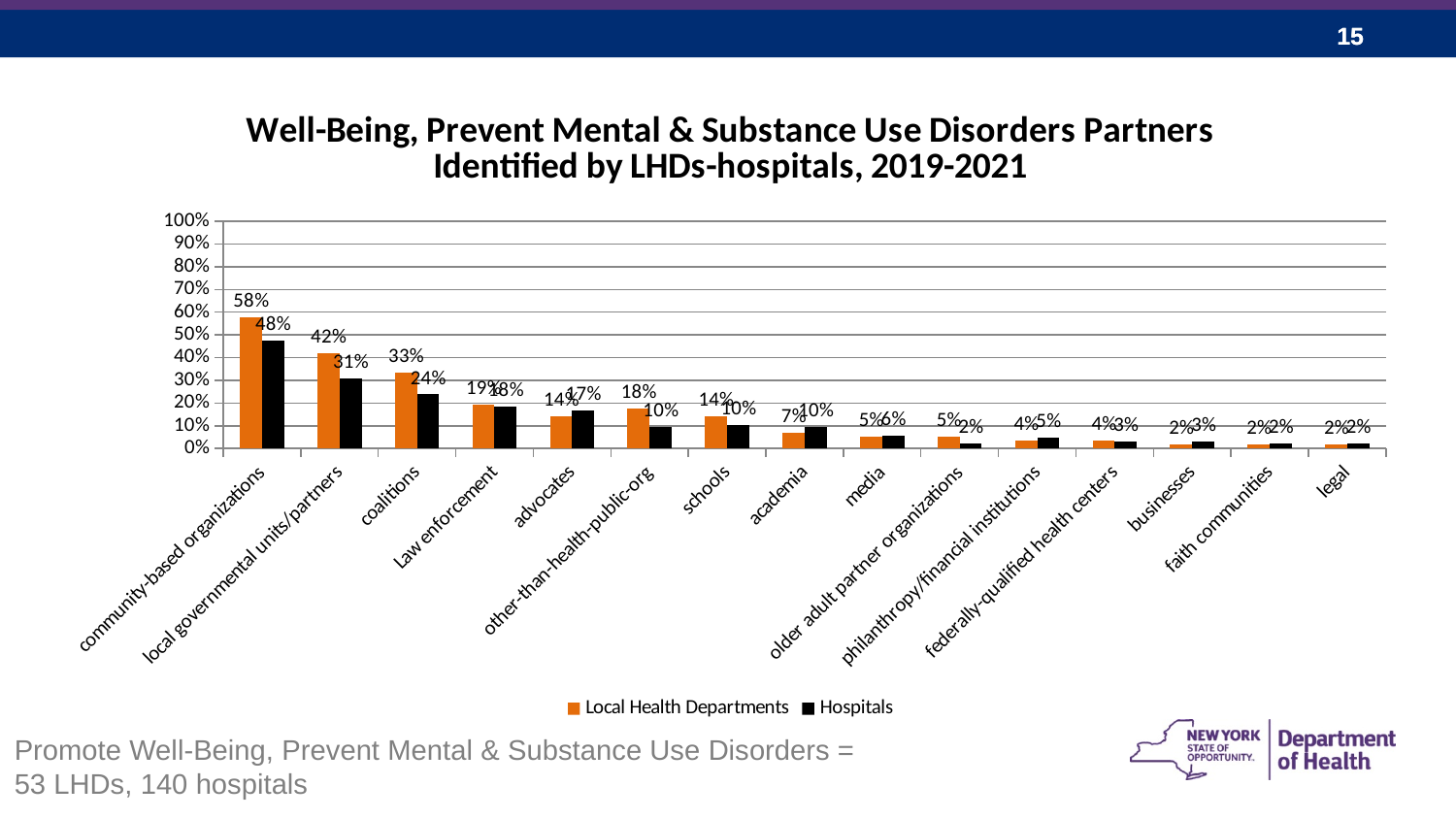
Is the Hospitals value for community-based organizations greater or less than 40%? greater What is the Hospitals value for coalitions? 24% For other-than-health-public-org, which series has the larger value, Local Health Departments or Hospitals? Local Health Departments How many series does the legend list? 2 What are the two series named in the legend? Local Health Departments and Hospitals Do the Local Health Departments values generally rise or fall from left to right along the x axis? fall How many partner categories are shown on the x axis? 15 What kind of chart is shown on the slide? bar chart What is the Hospitals value for local governmental units/partners? 31% What is the difference between the Local Health Departments and Hospitals values for community-based organizations? 10 percentage points What percentage of Local Health Departments identified community-based organizations as partners? 58% Which partner category has the highest value for Local Health Departments? community-based organizations